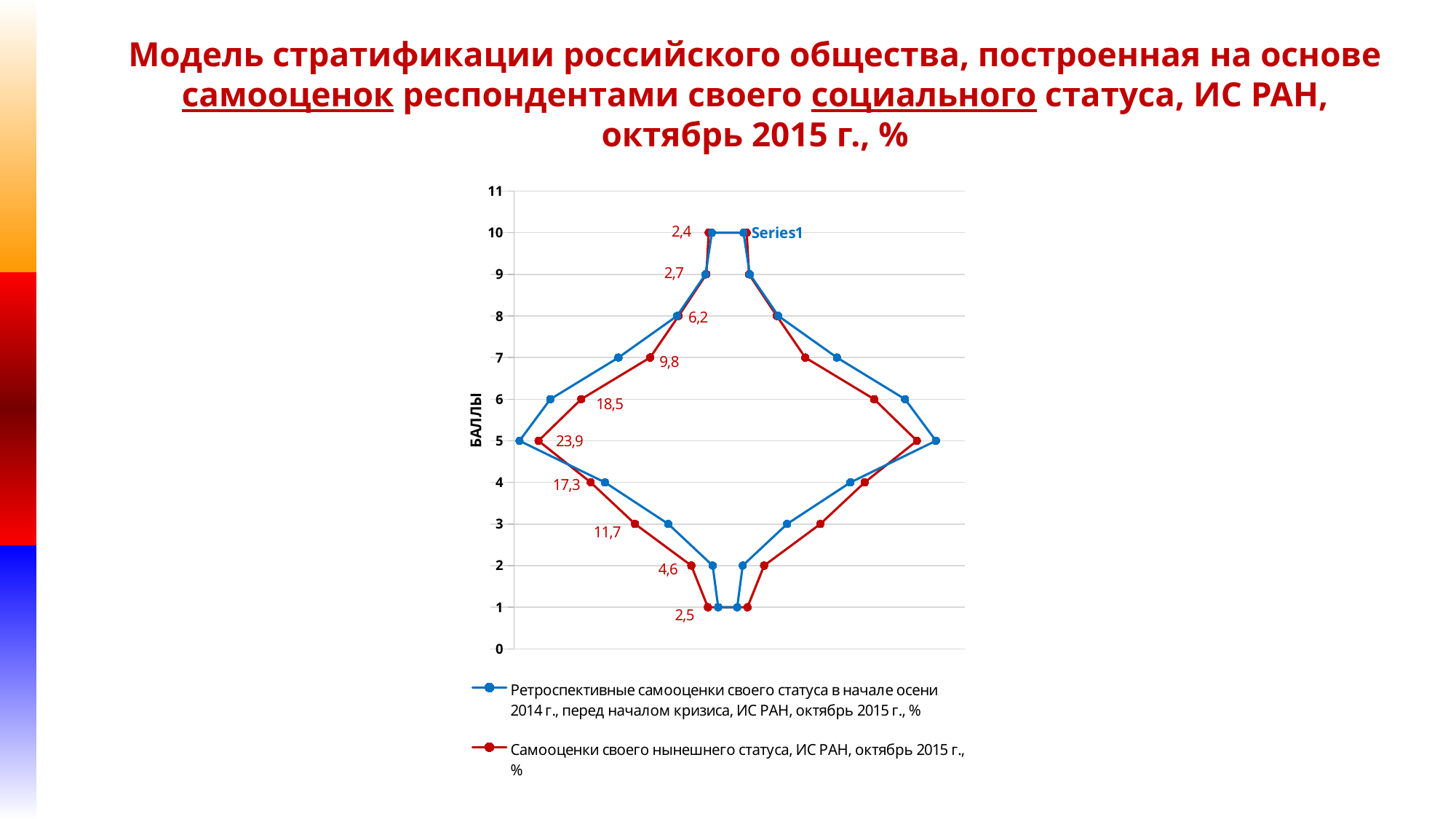
What is the value of the current self-assessment series at score 6? 18,5 What is the value of the current self-assessment series (Самооценки своего нынешнего статуса) at score 5? 23,9 What is the value of the current self-assessment series at score 1? 2,5 What is the value of the current self-assessment series at score 10? 2,4 At score 3, which series has the larger value: the retrospective 2014 self-assessment or the current self-assessment? Current self-assessment (Самооценки своего нынешнего статуса) At which score does the current self-assessment series have its lowest value? 10 What is the difference between the current self-assessment values at score 4 and score 3? 5,6 How many series does the legend list? 2 At which score does the current self-assessment series reach its highest value? 5 At score 5, which series has the larger value: the retrospective 2014 self-assessment or the current self-assessment? Retrospective 2014 self-assessment (Ретроспективные самооценки) What is the label of the vertical axis? БАЛЛЫ What is the difference between the current self-assessment values at score 5 and score 6? 5,4